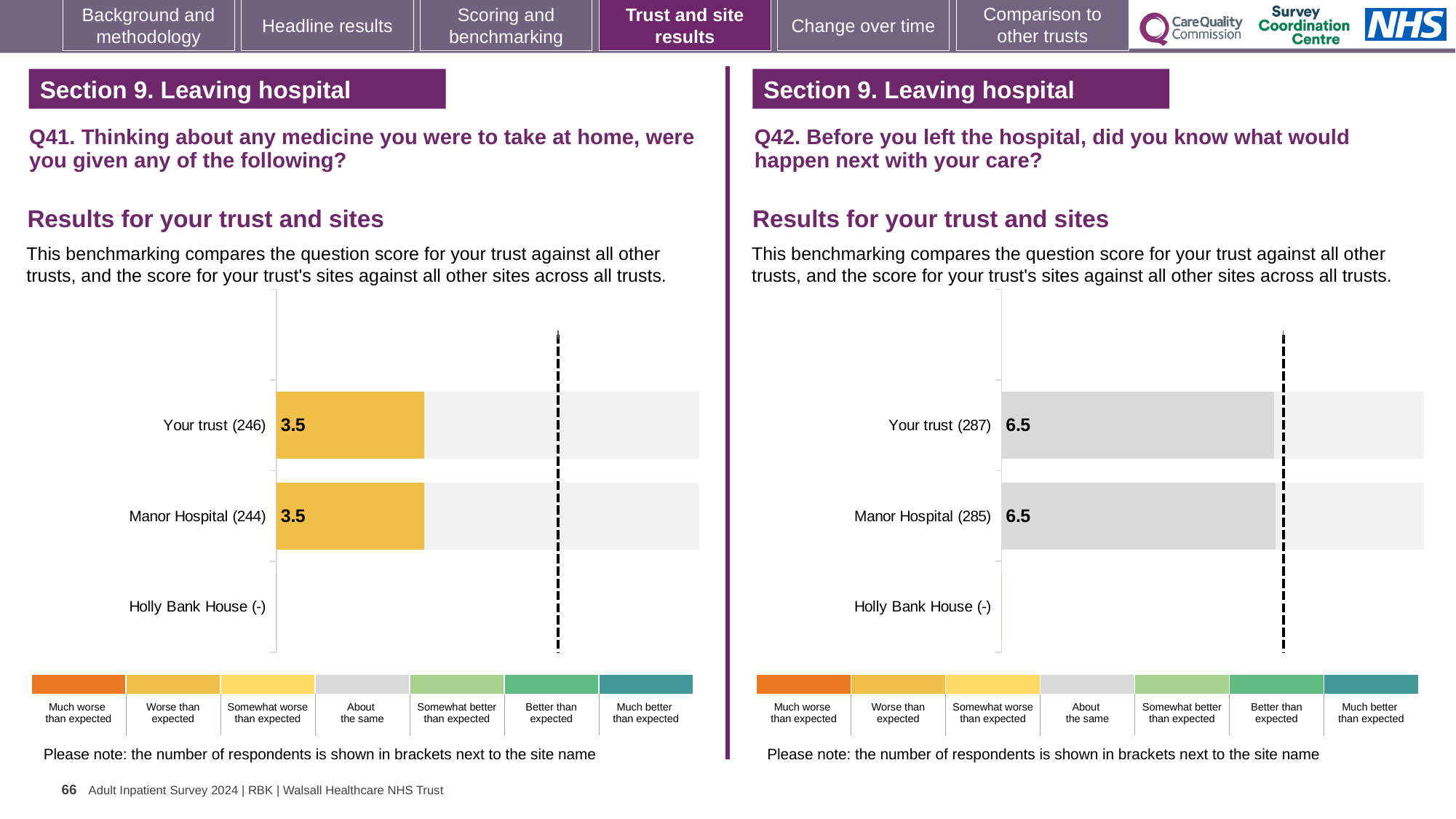
On the right chart (Q42), what is the score for Your trust (287)? 6.5 On the left chart (Q41), which benchmark category does the colour of the Your trust bar correspond to? Worse than expected On the left chart (Q41), which category has no score shown? Holly Bank House (-) On the left chart (Q41), what is the difference between the scores for Your trust and Manor Hospital? 0 What kind of chart is used on the right (Q42)? Bar chart On the left chart (Q41), what is the score for Manor Hospital (244)? 3.5 How many site/trust categories are listed on the left chart (Q41)? 3 On the left chart (Q41), what is the score for Your trust (246)? 3.5 On the right chart (Q42), what is the difference between the scores for Your trust and Manor Hospital? 0 Is the score for Your trust on the right chart (Q42) larger or smaller than the score for Your trust on the left chart (Q41)? Larger How many respondents are shown in brackets for Manor Hospital on the right chart (Q42)? 285 On the right chart (Q42), what is the score for Manor Hospital (285)? 6.5